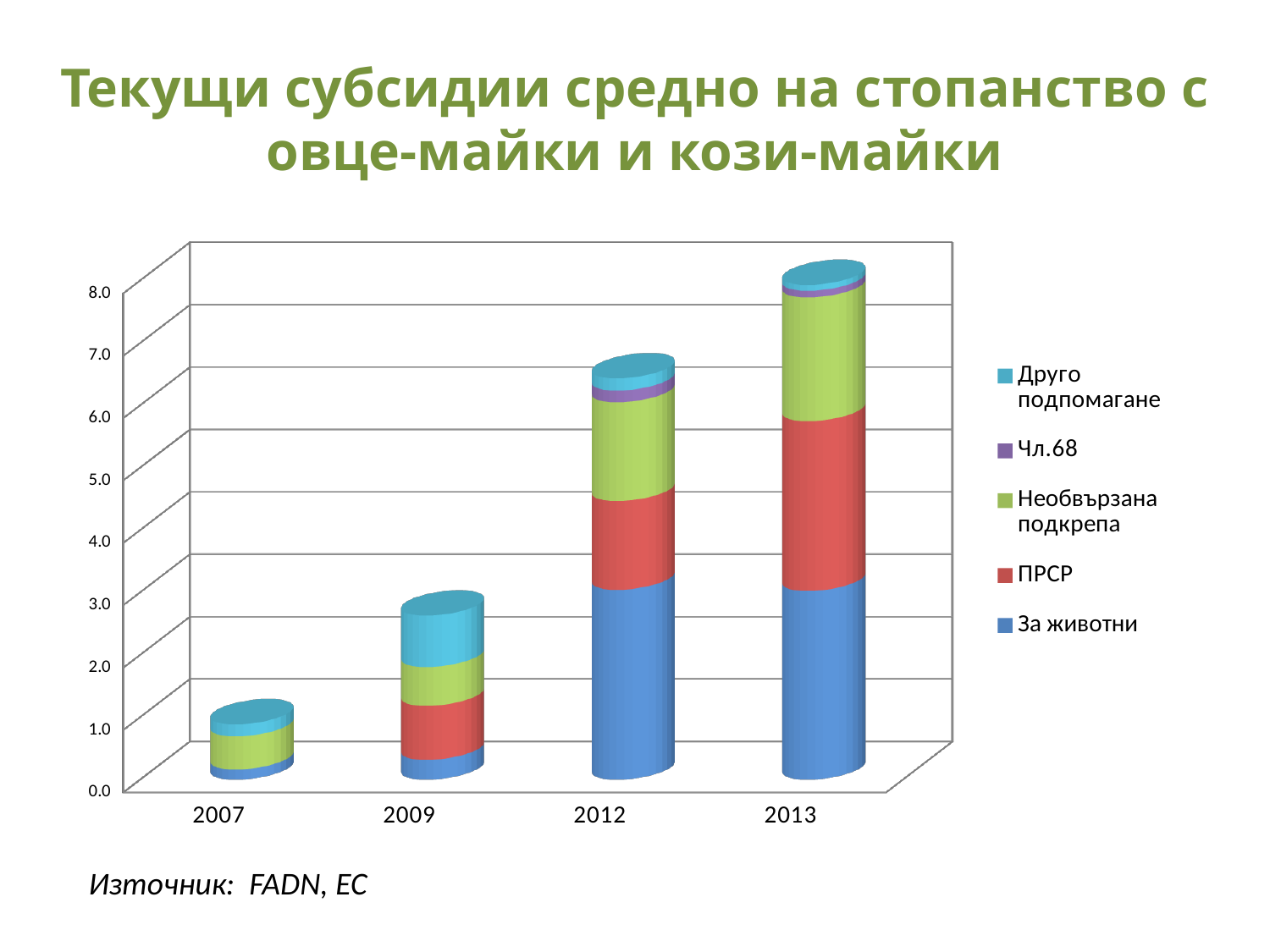
Which year has the lowest total subsidies? 2007 Which series is shown in blue at the bottom of the stacked bars? За животни Do the total subsidies rise or fall from 2007 to 2013? rise Is the total value for 2012 greater or less than 6.0? greater Is the total value for 2009 greater or less than 2.0? greater What source is cited below the chart? FADN, EC What kind of chart is shown on the slide? stacked bar chart How many series does the legend list? 5 Which year has the highest total subsidies? 2013 Is the total value for 2007 greater or less than 2.0? less How many years (categories) are shown on the x axis? 4 Which year has the larger total, 2012 or 2013? 2013